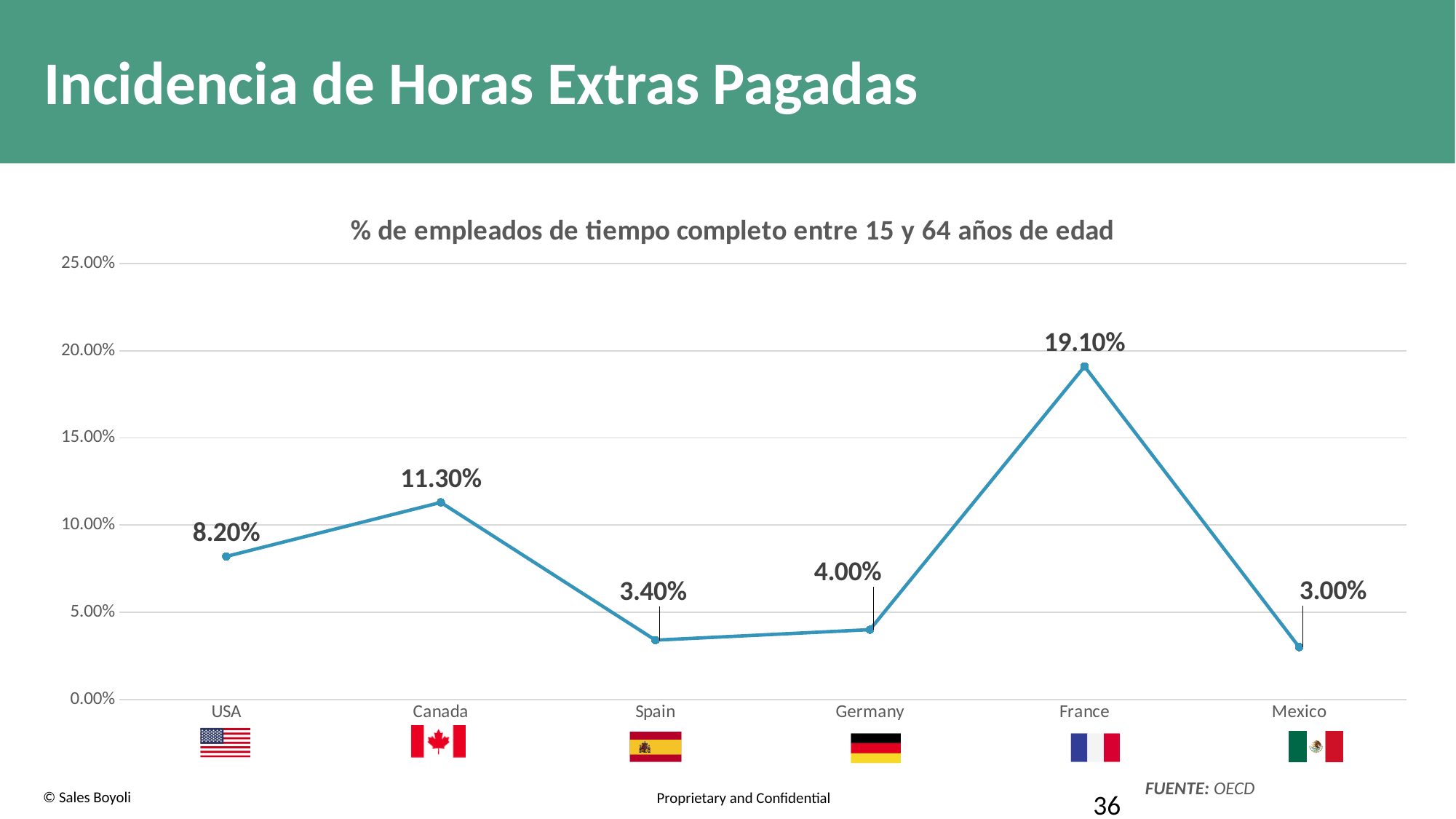
What kind of chart is shown on the slide? line chart Which is larger, the value for Germany or the value for Spain? Germany Is the value for USA greater or less than 10.00%? less Which country has the lowest value? Mexico What is the value for Canada? 11.30% What is the title of the chart? % de empleados de tiempo completo entre 15 y 64 años de edad How many countries are shown on the x axis? 6 What is the value for France? 19.10% What is the value for Spain? 3.40% What is the difference between the values for Canada and USA? 3.10% What is the difference between the values for France and Mexico? 16.10% Which country has the highest value? France